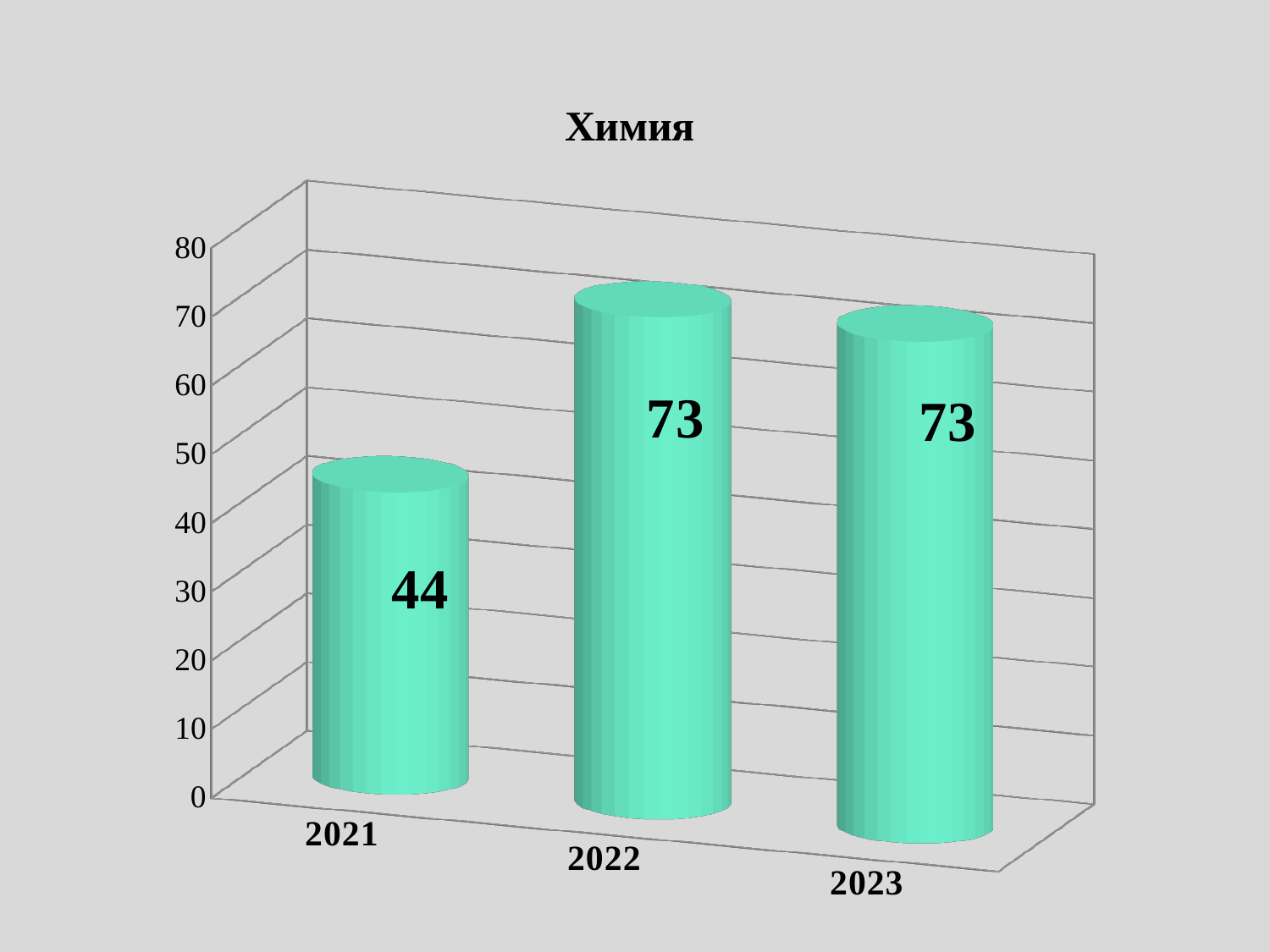
Which is larger, the value for 2021 or the value for 2023? 2023 How many years are shown on the chart? 3 Is the value for 2021 greater or less than 50? less Which year has the lowest value? 2021 What is the title of the chart? Химия What kind of chart is shown on the slide? bar chart What is the difference between the values for 2022 and 2021? 29 What is the value for 2023? 73 What is the value for 2021? 44 Does the value rise or fall from 2021 to 2022? rise What is the value for 2022? 73 Is the value for 2022 greater or less than 60? greater